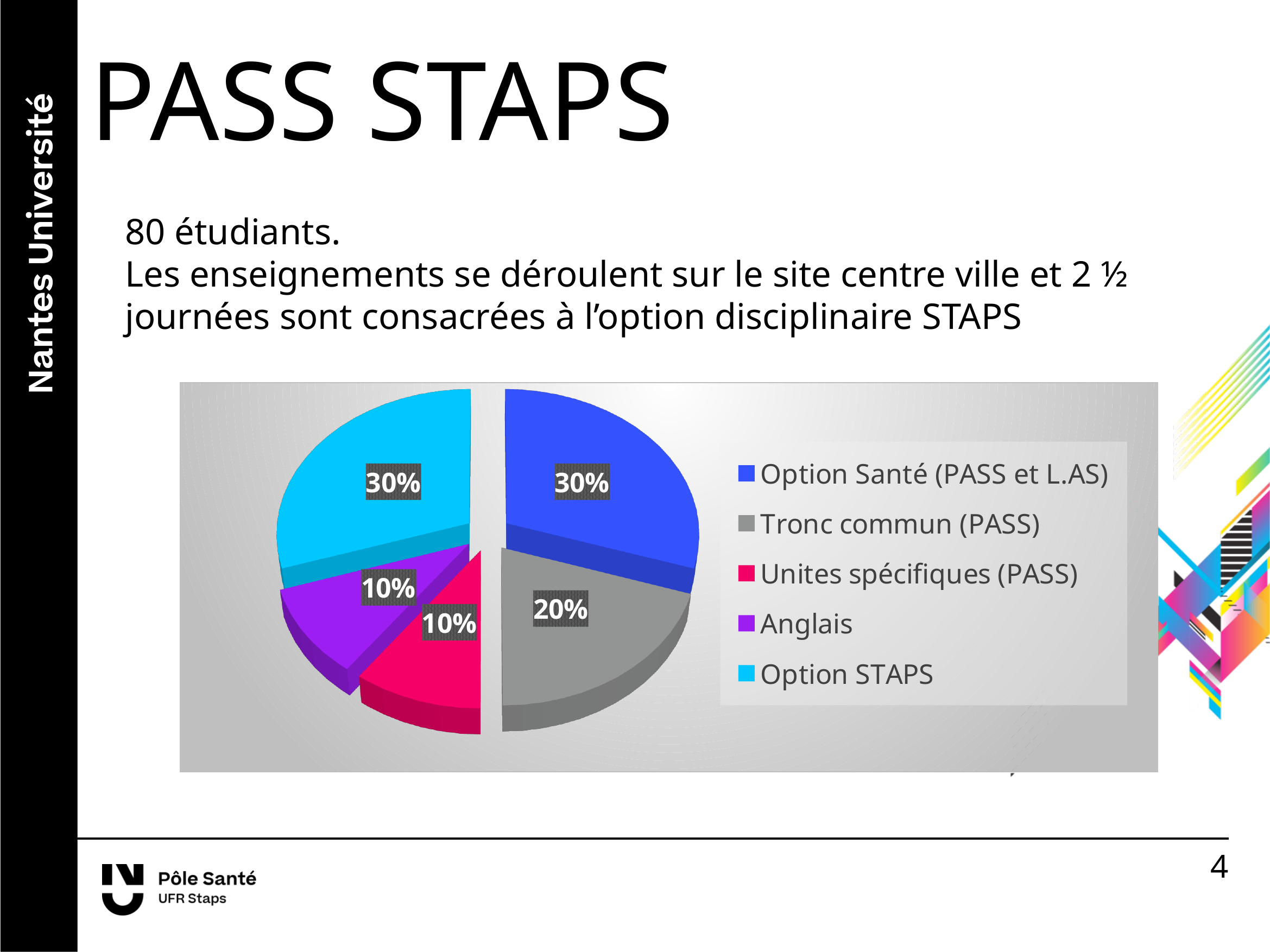
What share of the pie does Option Santé (PASS et L.AS) represent? 30% How many slices does the pie chart have? 5 What kind of chart is shown on the slide? pie chart What is the value shown for Unites spécifiques (PASS)? 10% Which is larger, Tronc commun (PASS) or Unites spécifiques (PASS)? Tronc commun (PASS) What is the value shown for Tronc commun (PASS)? 20% What share of the pie does Option STAPS represent? 30% What is the difference between the values for Tronc commun (PASS) and Anglais? 10% Which is larger, Option Santé (PASS et L.AS) or Tronc commun (PASS)? Option Santé (PASS et L.AS) What is the value shown for Anglais? 10% How many entries does the legend list? 5 What colour is the slice for Option STAPS? light blue (cyan)